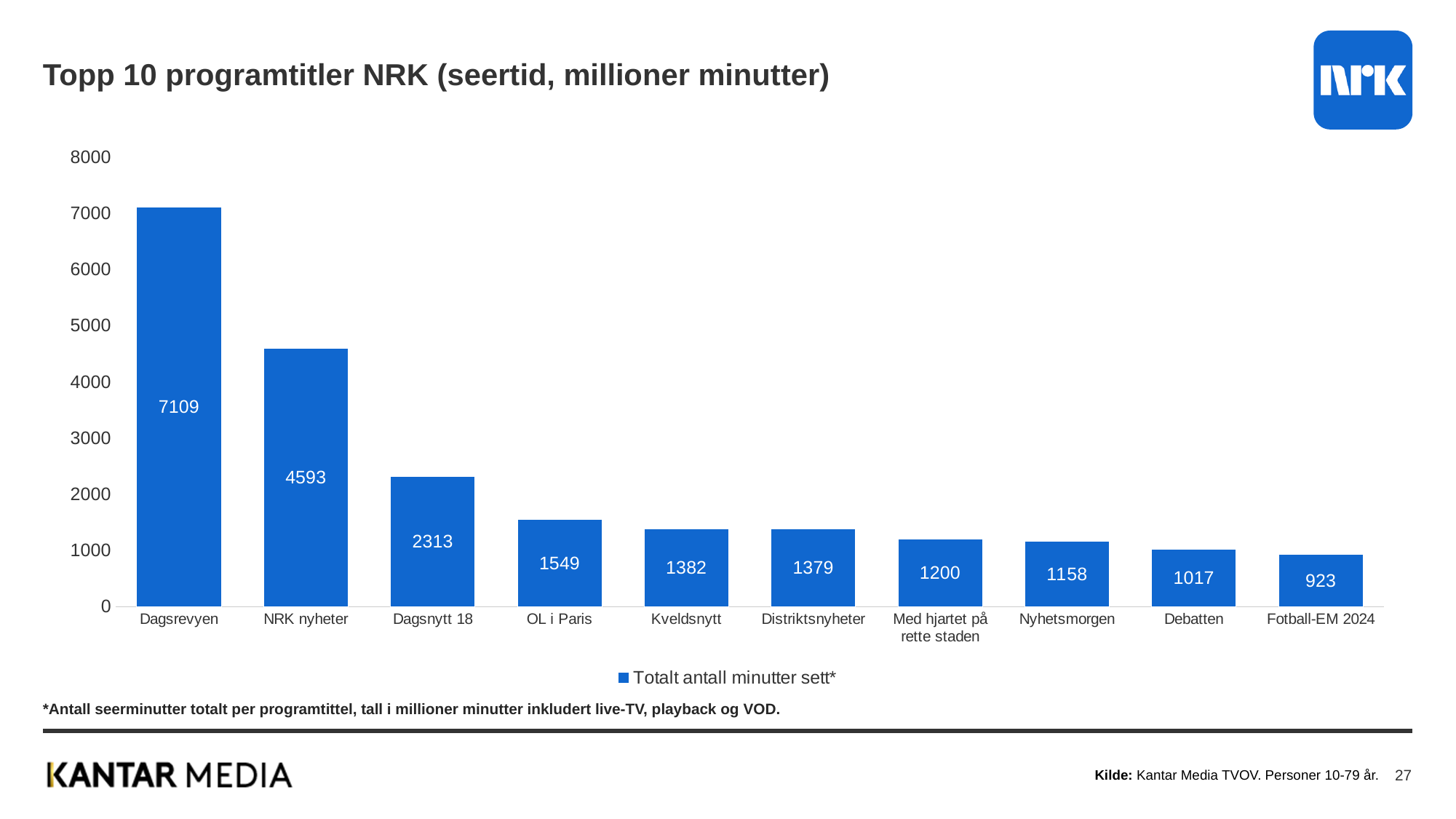
What is the value for Med hjartet på rette staden? 1200 What is the value for OL i Paris? 1549 What is the value for Dagsrevyen? 7109 How many series does the legend list? 1 What is the title of the chart? Topp 10 programtitler NRK (seertid, millioner minutter) How many program titles are shown on the chart? 10 Which program title has the lowest value? Fotball-EM 2024 Which is larger, the value for Dagsnytt 18 or the value for Kveldsnytt? Dagsnytt 18 What kind of chart is shown on the slide? bar chart Is the value for NRK nyheter greater or less than 4000? greater Which program title has the highest value? Dagsrevyen What is the difference between the values for Dagsrevyen and NRK nyheter? 2516